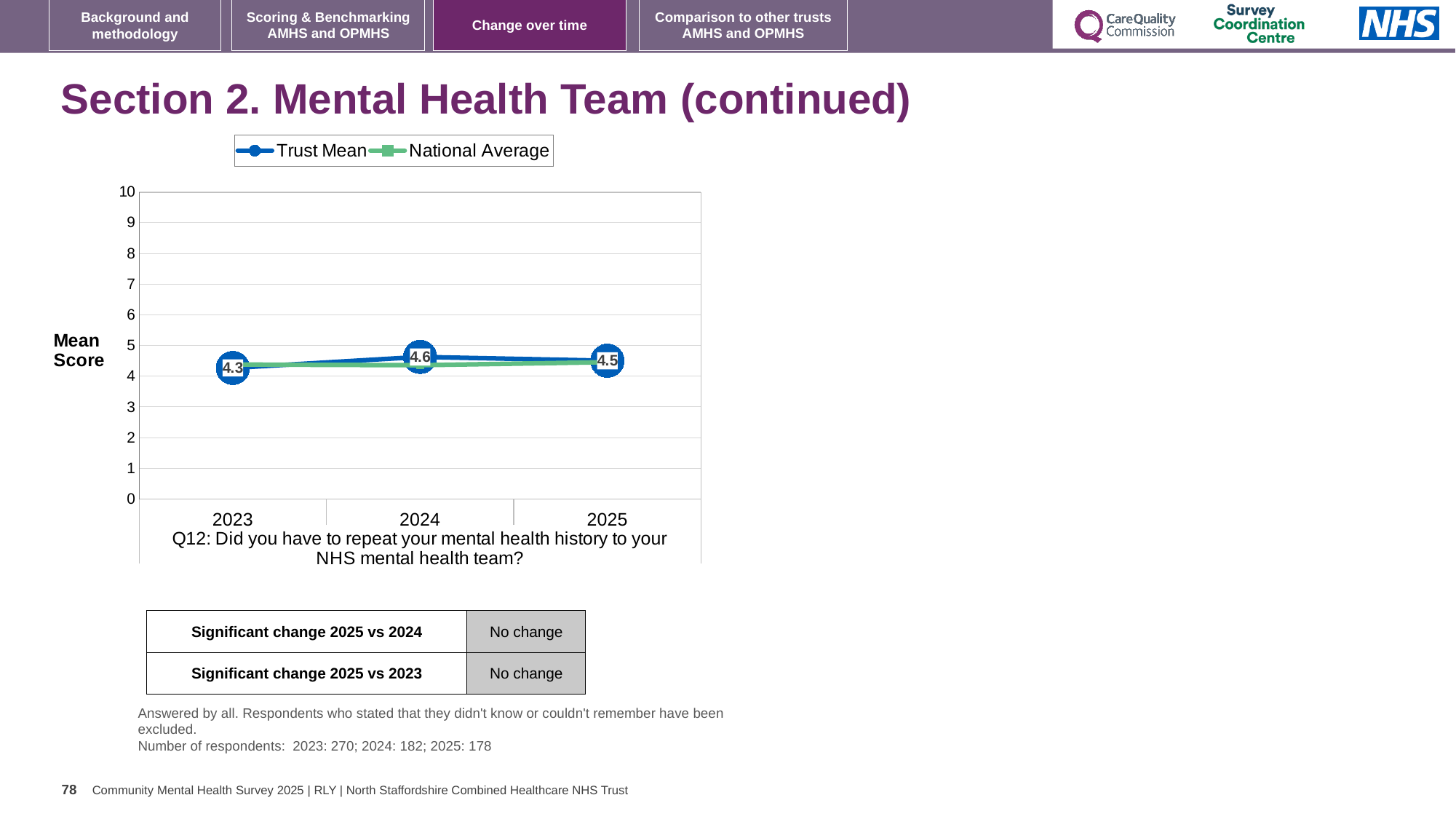
What is the Trust Mean score for 2024? 4.6 What is the Trust Mean score for 2025? 4.5 In which year is the Trust Mean lowest? 2023 What kind of chart is shown on the slide? line chart In which year is the Trust Mean highest? 2024 Is the Trust Mean higher in 2025 or in 2023? 2025 Is the National Average value for 2024 greater or less than 5? less How many series does the legend list? 2 What is the difference between the Trust Mean in 2024 and in 2023? 0.3 How many years are plotted on the x axis? 3 Does the Trust Mean rise or fall from 2023 to 2024? rise What is the Trust Mean score for 2023? 4.3